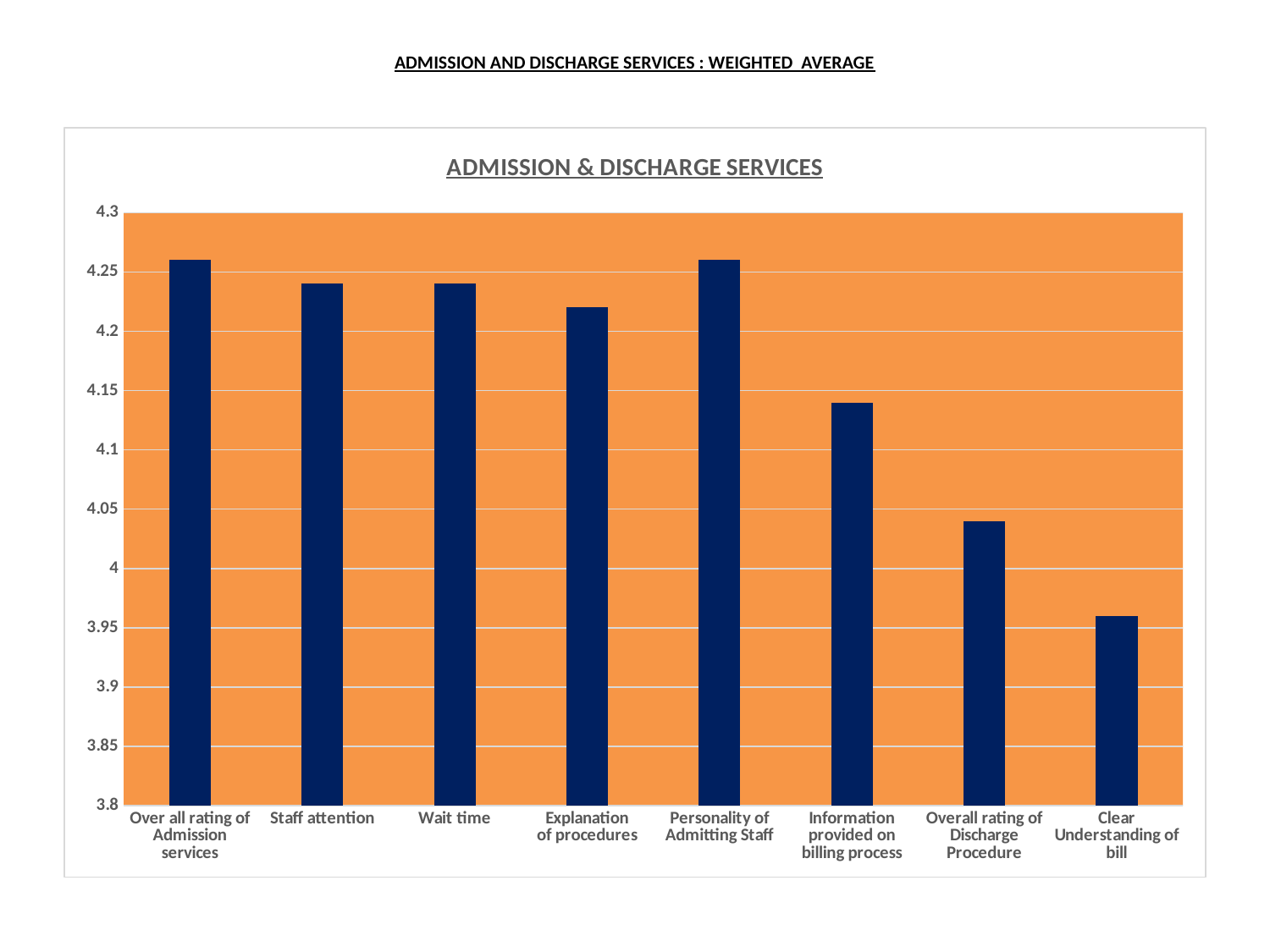
Which is larger, the value for Information provided on billing process or the value for Clear Understanding of bill? Information provided on billing process Which is larger, the value for Wait time or the value for Overall rating of Discharge Procedure? Wait time How many categories are plotted on the chart? 8 What kind of chart is shown on the slide? bar chart Which category has the lowest value? Clear Understanding of bill Is the value for Overall rating of Discharge Procedure greater or less than 4? greater Is the value for Clear Understanding of bill greater or less than 4? less Is the value for Staff attention greater or less than 4.2? greater Do the values generally rise or fall from left to right across the categories? fall What is the title shown inside the chart area? ADMISSION & DISCHARGE SERVICES